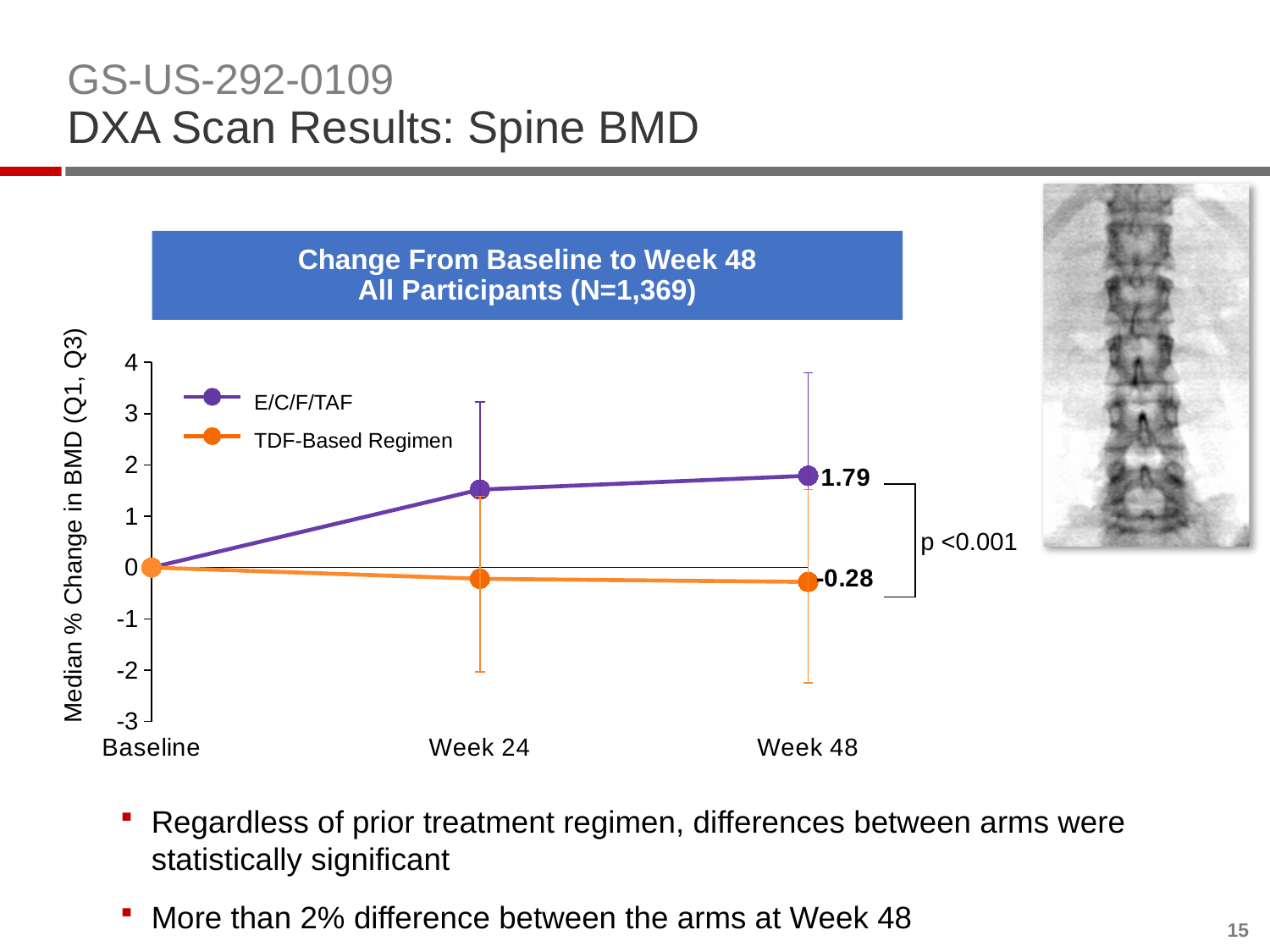
Does the E/C/F/TAF series rise or fall from Baseline to Week 48? Rise What kind of chart is shown? Line chart What p-value is shown for the difference between arms at Week 48? p <0.001 Which series has the higher value at Week 48? E/C/F/TAF Is the value for E/C/F/TAF at Week 24 greater or less than 1? greater Is the value for E/C/F/TAF at Week 24 greater or less than 2? less What is the value for the TDF-Based Regimen at Week 48? -0.28 What is the value for E/C/F/TAF at Week 48? 1.79 How many series does the legend list? 2 What is the value for both series at Baseline? 0 How many time points are plotted on the x axis? 3 What is the difference between the E/C/F/TAF and TDF-Based Regimen values at Week 48? 2.07